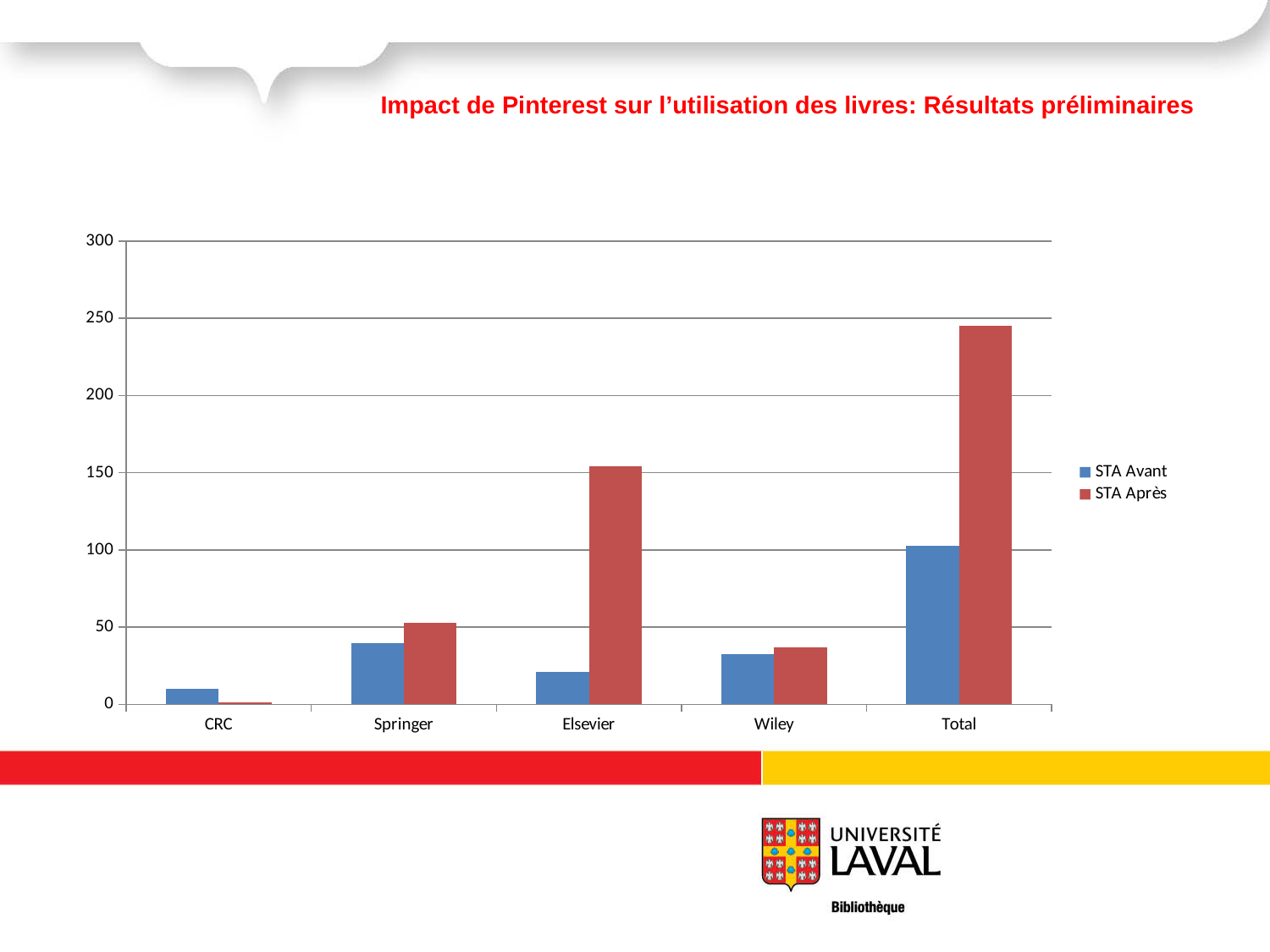
Which category has the highest STA Après value? Total For Elsevier, which is larger: STA Avant or STA Après? STA Après How many categories are shown on the x axis? 5 Which category has the lowest STA Avant value? CRC Is the STA Après value for Total greater or less than 200? greater Is the STA Avant value for CRC greater or less than 50? less What kind of chart is shown on the slide? bar chart Which category has the lowest STA Après value? CRC How many series does the legend list? 2 For CRC, which is larger: STA Avant or STA Après? STA Avant Is the STA Après value for Elsevier greater or less than 100? greater What colour are the STA Après bars? red